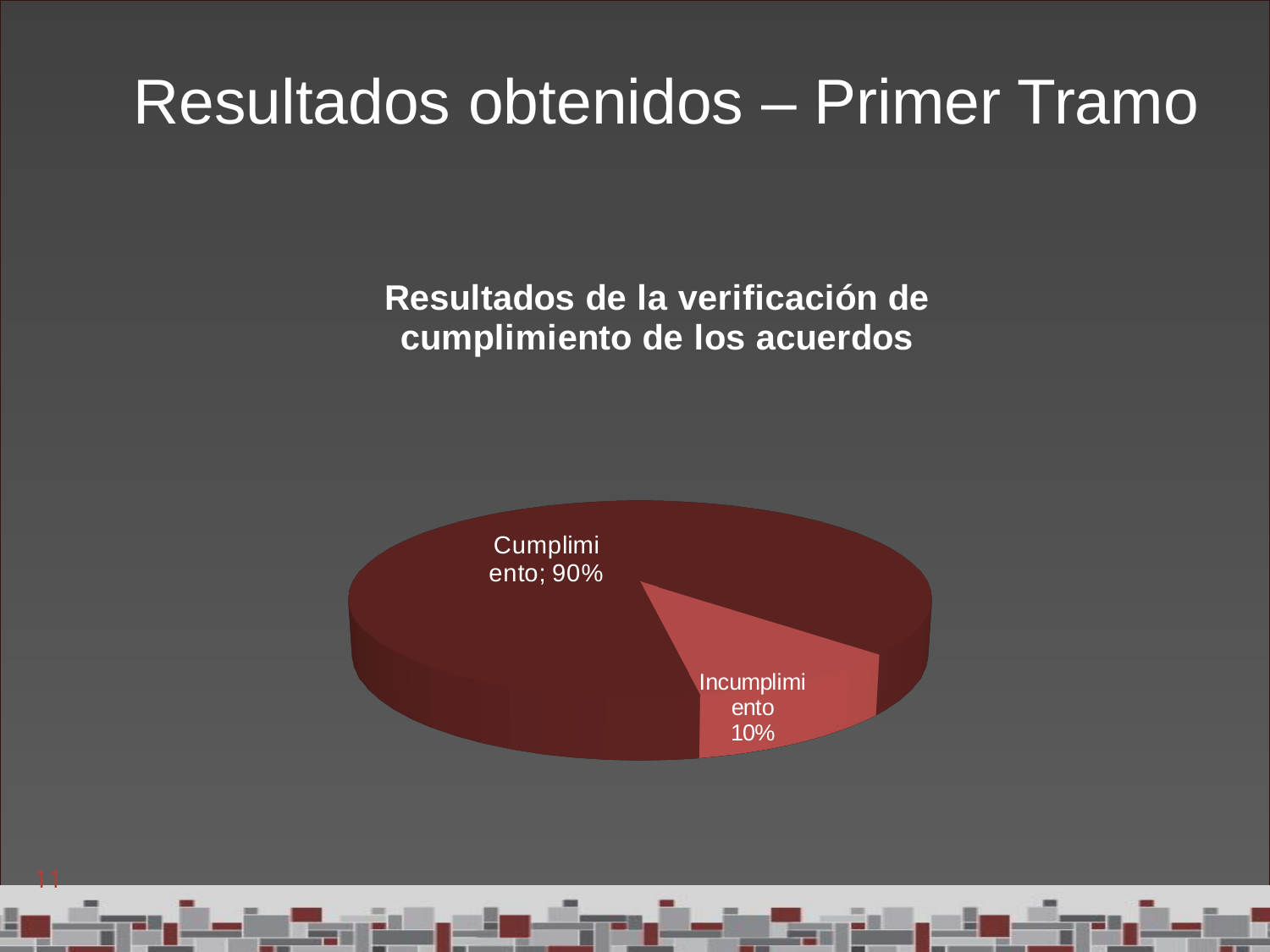
Which slice is the largest? Cumplimiento What is the value for Cumplimiento? 90% Which slice is the smallest? Incumplimiento Which is larger, Cumplimiento or Incumplimiento? Cumplimiento What share of the pie does Incumplimiento represent? 10% How many slices does the pie chart have? 2 What is the value for Incumplimiento? 10% What is the difference between the Cumplimiento and Incumplimiento values? 80% What is the total of the two slices shown? 100% What kind of chart is shown on the slide? pie chart What is the title of the chart? Resultados de la verificación de cumplimiento de los acuerdos